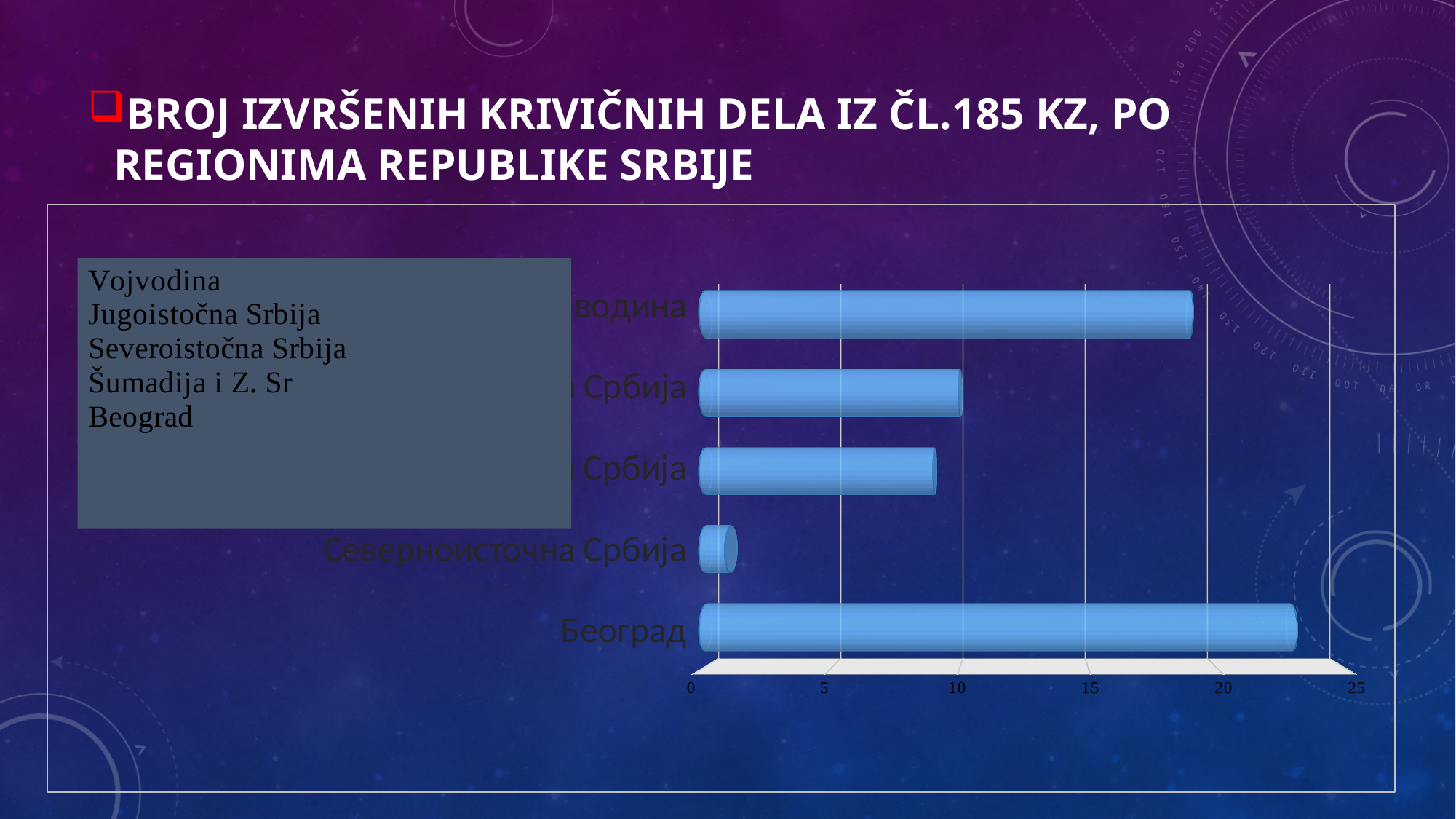
What is the highest tick value shown on the horizontal axis? 25 Is the value for Београд greater or less than 20? greater Which region has the highest value in the chart? Београд What is the title of the slide containing the chart? BROJ IZVRŠENIH KRIVIČNIH DELA IZ ČL.185 KZ, PO REGIONIMA REPUBLIKE SRBIJE Is the value for Београд greater or less than 25? less Which region has the lowest value in the chart? Северноисточна Србија Which has a larger value, Београд or Североисточна Србија? Београд How many regions (bars) are plotted in the chart? 5 Is the value for Североисточна Србија greater or less than 5? less What kind of chart is shown on the slide? bar chart